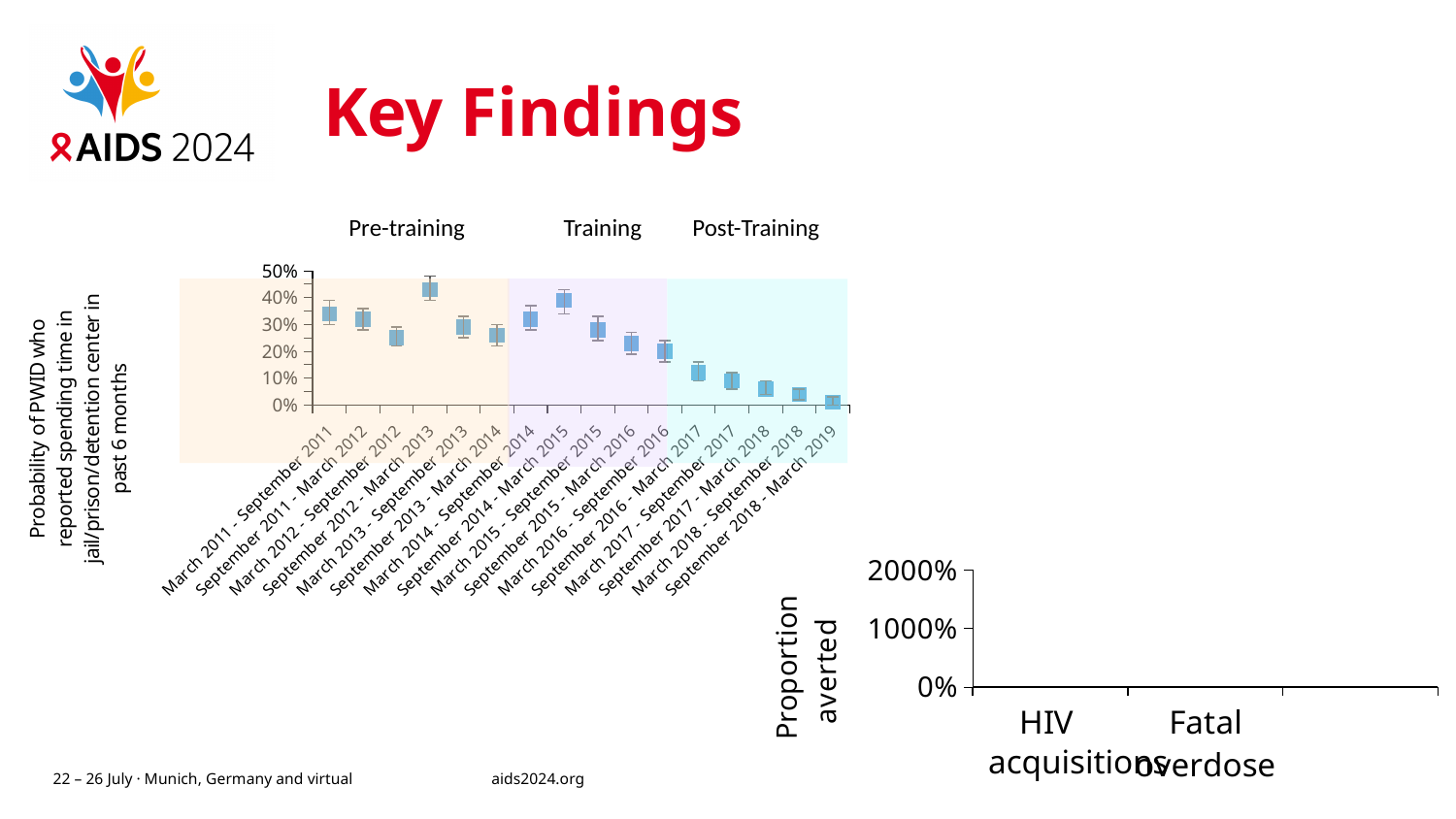
On the jail/prison/detention center chart, which time period has the highest probability? September 2012 - March 2013 On the jail/prison/detention center chart, is the value for September 2018 - March 2019 greater or less than 10%? less On the jail/prison/detention center chart, do the values rise or fall across the Post-Training period? fall On the jail/prison/detention center chart, is the value for September 2014 - March 2015 greater or less than 30%? greater On the jail/prison/detention center chart, how many time periods are plotted along the x axis? 16 On the 'Proportion averted' chart at the bottom right, what are the two category labels on the x axis? HIV acquisitions, Fatal overdose On the jail/prison/detention center chart, is the value for March 2011 - September 2011 greater or less than 30%? greater On the chart of probability of PWID who reported spending time in jail/prison/detention center, what kind of chart is it? Scatter/point chart with error bars On the jail/prison/detention center chart, what are the three phases labelled above the plot? Pre-training, Training, Post-Training On the jail/prison/detention center chart, which time period has the lowest probability? September 2018 - March 2019 On the jail/prison/detention center chart, which is larger: the value for March 2013 - September 2013 or the value for September 2012 - March 2013? September 2012 - March 2013